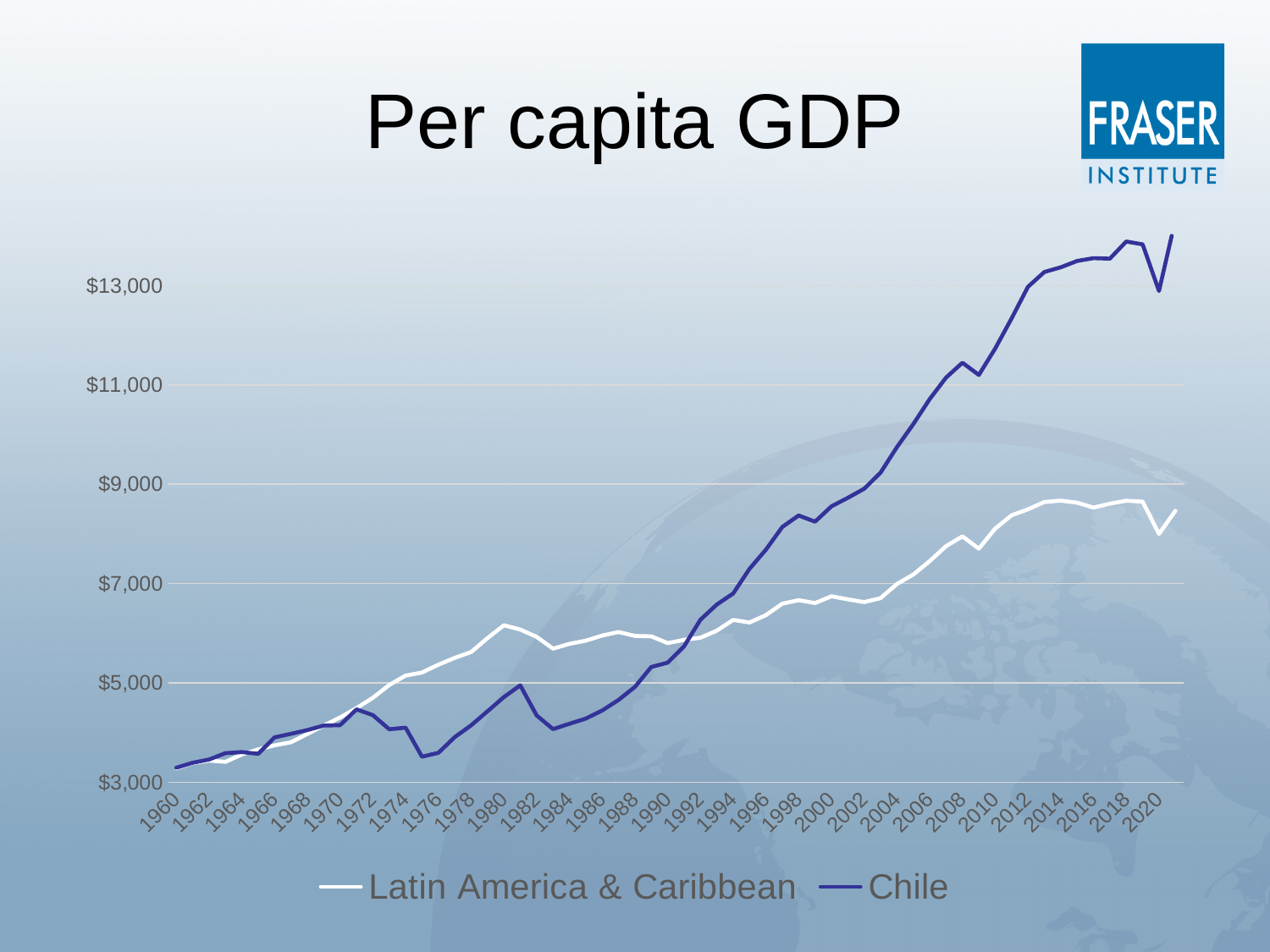
How many series does the legend list? 2 Is the value for Chile in 2018 greater or less than $13,000? greater Overall, does the Chile line rise or fall from 1960 to 2020? rise Is the value for Latin America & Caribbean in 2020 greater or less than $9,000? less What is the title of the chart? Per capita GDP In 2020, which series has the higher per capita GDP, Chile or Latin America & Caribbean? Chile Which series reaches the highest value on the chart? Chile Is the value for Latin America & Caribbean in 1980 greater or less than $5,000? greater In 1980, which series has the higher per capita GDP, Chile or Latin America & Caribbean? Latin America & Caribbean What kind of chart is shown on the slide? line chart Which series is drawn with the dark blue line? Chile